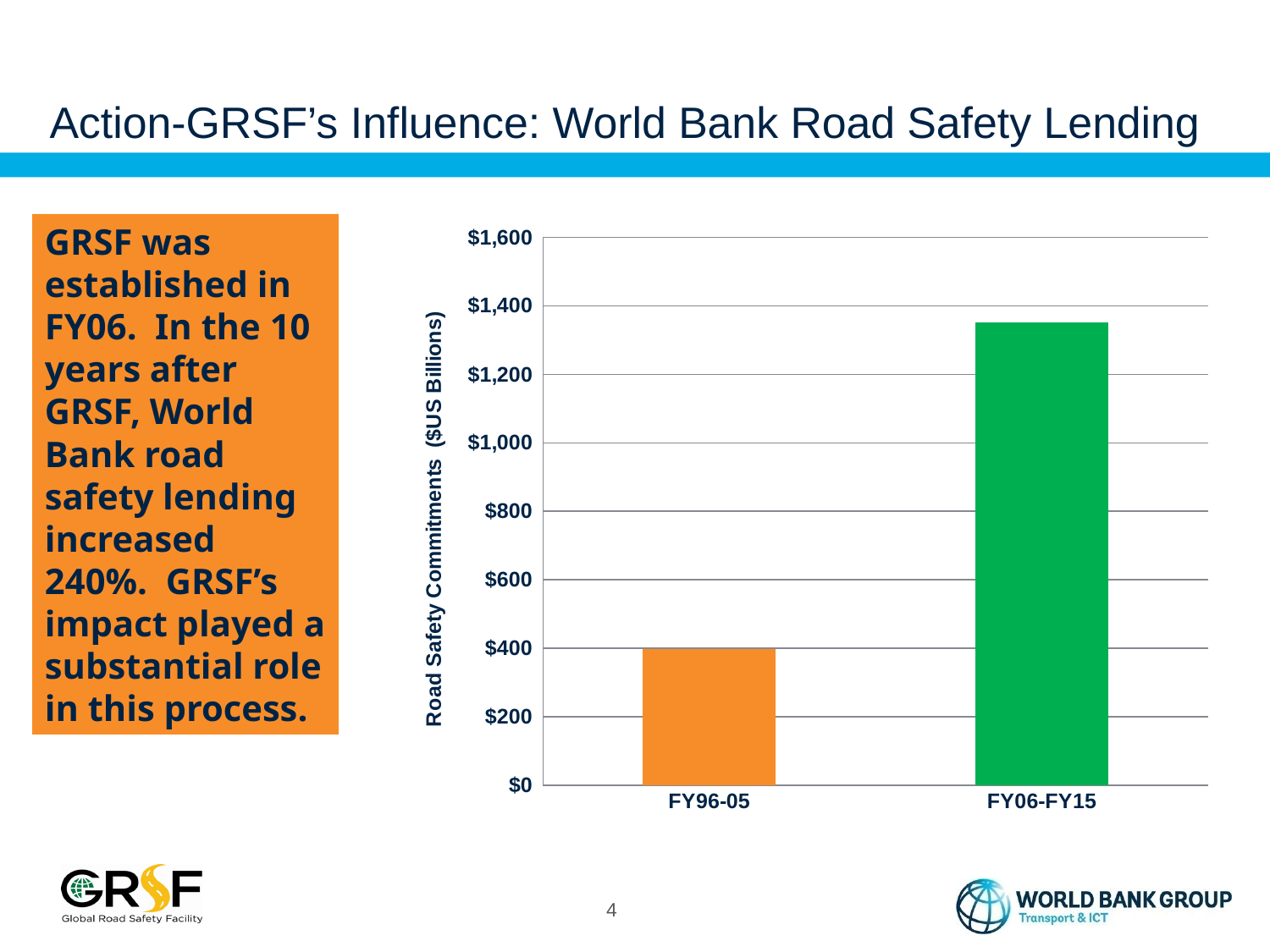
Do the values rise or fall from FY96-05 to FY06-FY15? rise Is the value for FY06-FY15 greater or less than $1,200? greater Which category has the lowest road safety commitments? FY96-05 What kind of chart is shown on the slide? bar chart What colour is the bar for FY06-FY15? green Is the value for FY96-05 greater or less than $600? less How many categories are shown on the x axis of the chart? 2 Is the value for FY96-05 greater or less than $200? greater Which is larger, the value for FY96-05 or the value for FY06-FY15? FY06-FY15 What is the title of the vertical axis of the chart? Road Safety Commitments ($US Billions) Which category has the highest road safety commitments? FY06-FY15